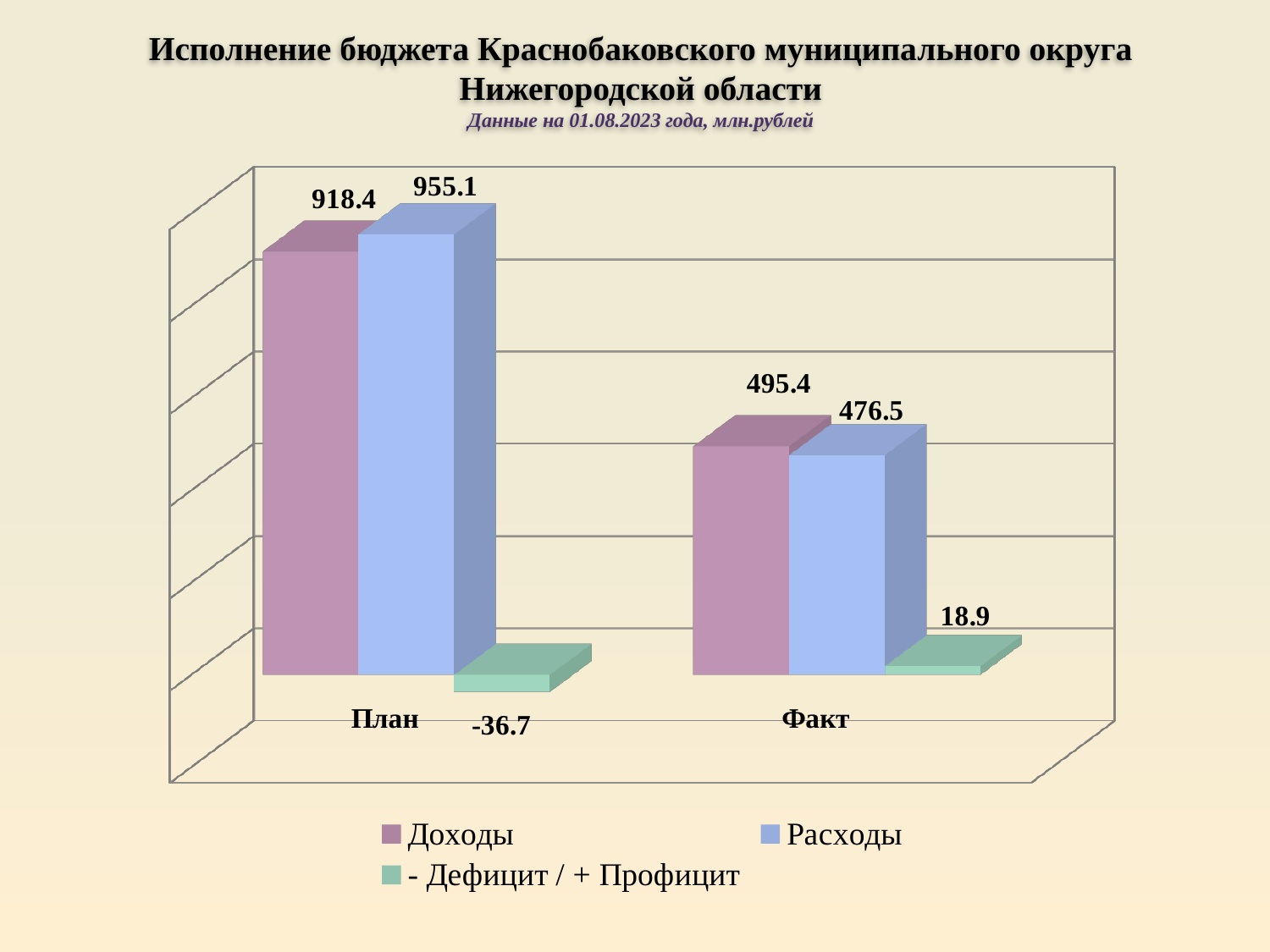
What is the difference between Расходы and Доходы for План? 36.7 For Факт, which is larger: Доходы or Расходы? Доходы What kind of chart is shown on the slide? Bar chart What is the value of Расходы for Факт? 476.5 How many series does the legend list? 3 What is the value of - Дефицит / + Профицит for Факт? 18.9 What is the value of - Дефицит / + Профицит for План? -36.7 Which category has the higher value for Расходы, План or Факт? План What is the value of Доходы for План? 918.4 What is the difference between Доходы for План and Доходы for Факт? 423 What date and unit are given in the chart subtitle? Данные на 01.08.2023 года, млн.рублей How many categories are shown on the x axis? 2